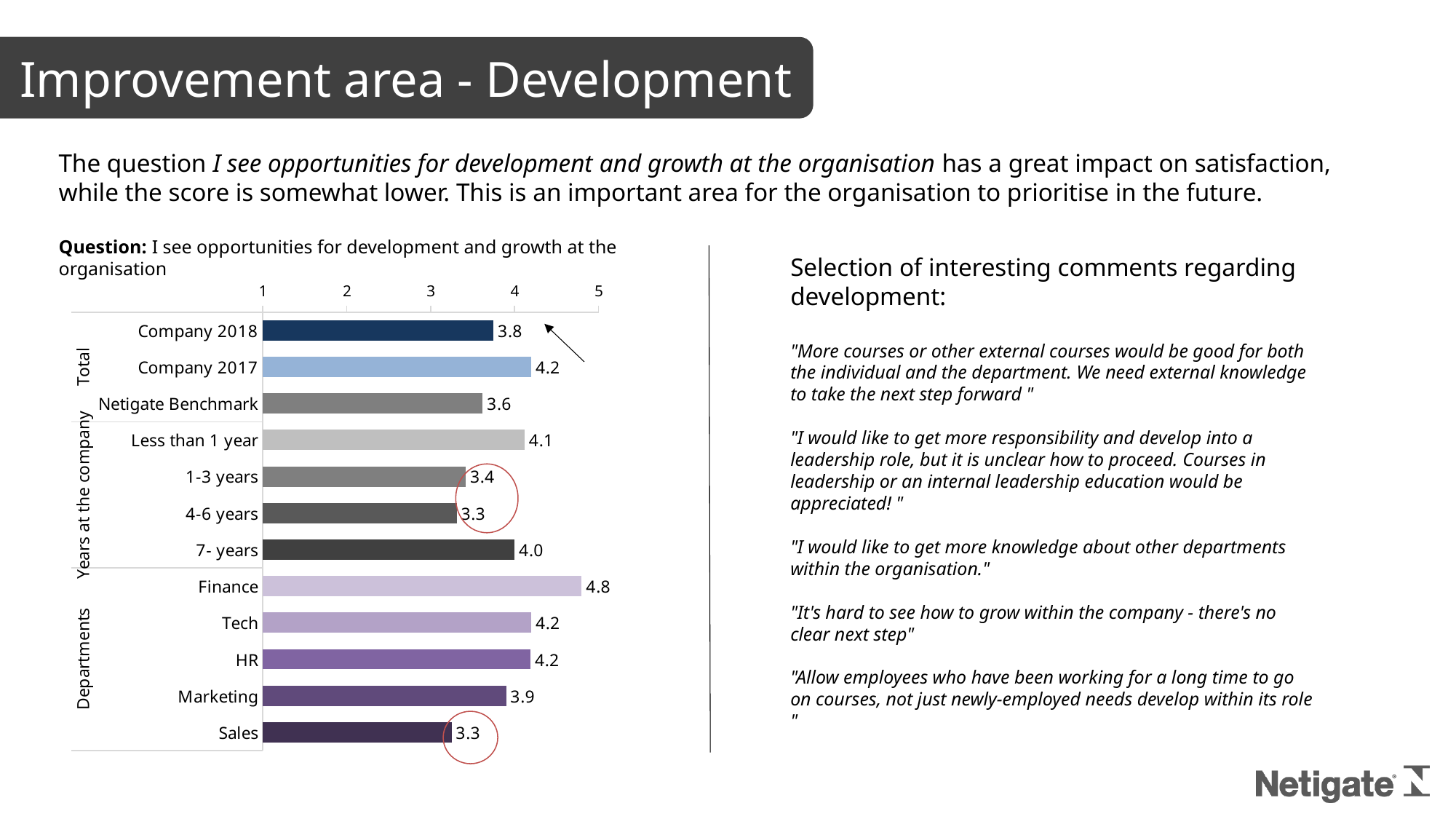
What is the value for 4-6 years? 3.3 What is the difference between Company 2017 and Company 2018? 0.4 What kind of chart is shown on the slide? bar chart How many bars are shown in the chart? 12 What is the value for Finance? 4.8 Which three group labels appear along the left side of the chart? Total, Years at the company, Departments Which is larger, the value for Less than 1 year or the value for 1-3 years? Less than 1 year Which category has the highest value? Finance What is the value for Company 2018? 3.8 What is the difference between Finance and Sales? 1.5 Is the value for Marketing greater or less than 4? less What is the value for Netigate Benchmark? 3.6